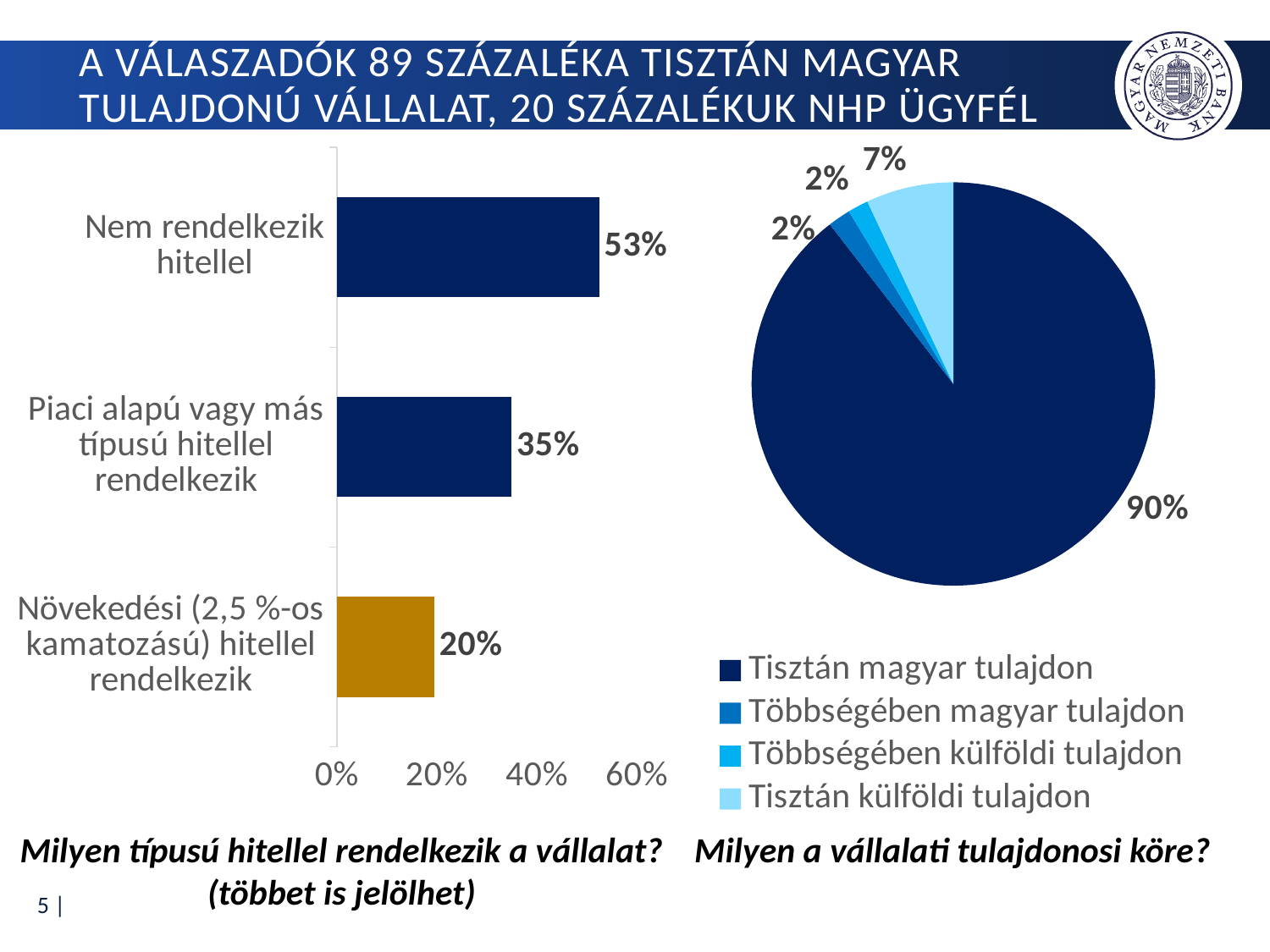
On the left bar chart, what is the value for "Növekedési (2,5 %-os kamatozású) hitellel rendelkezik"? 20% On the left bar chart, which category has the lowest value? Növekedési (2,5 %-os kamatozású) hitellel rendelkezik What type of chart is the chart on the left side of the slide? Bar chart How many entries does the legend of the right pie chart list? 4 On the left bar chart, what is the value for "Nem rendelkezik hitellel"? 53% On the left bar chart, which category has the highest value? Nem rendelkezik hitellel On the right pie chart, which slice is the largest? Tisztán magyar tulajdon On the left bar chart, how many categories are shown? 3 On the right pie chart, what share does "Tisztán magyar tulajdon" have? 90% On the right pie chart, what share does "Tisztán külföldi tulajdon" have? 7% On the left bar chart, what is the difference between "Nem rendelkezik hitellel" and "Piaci alapú vagy más típusú hitellel rendelkezik"? 18% On the left bar chart, which bar is shown in a different colour (gold) from the others? Növekedési (2,5 %-os kamatozású) hitellel rendelkezik